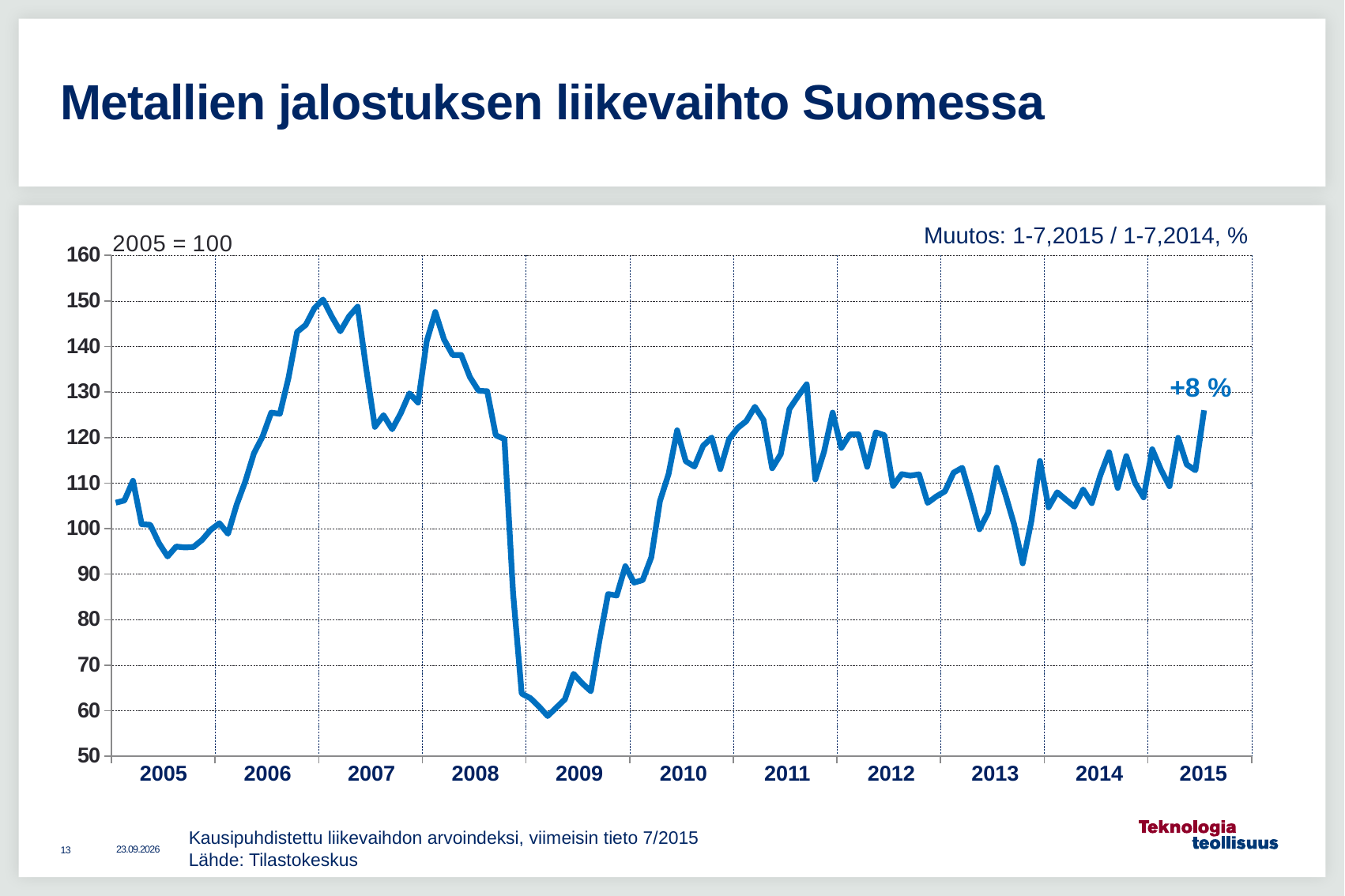
What is the lowest value shown on the y axis? 50 Is the value at the start of the series in 2005 greater or less than 100? greater Which is higher: the peak of the line around 2006/2007 or the peak around 2011? the peak around 2006/2007 How many year labels are shown on the x axis? 11 What is the title of the chart on the slide? Metallien jalostuksen liikevaihto Suomessa Is the highest point of the line, reached around 2006/2007, greater or less than 140? greater Does the line rise or fall from the start of 2005 to mid-2006? rise What base-year note is printed at the top left of the chart? 2005 = 100 What kind of chart is shown on the slide? line chart What percentage change is annotated at the end of the line? +8 % Is the lowest point of the line, reached around the turn of 2008/2009, greater or less than 70? less Does the line rise or fall during the second half of 2008? fall